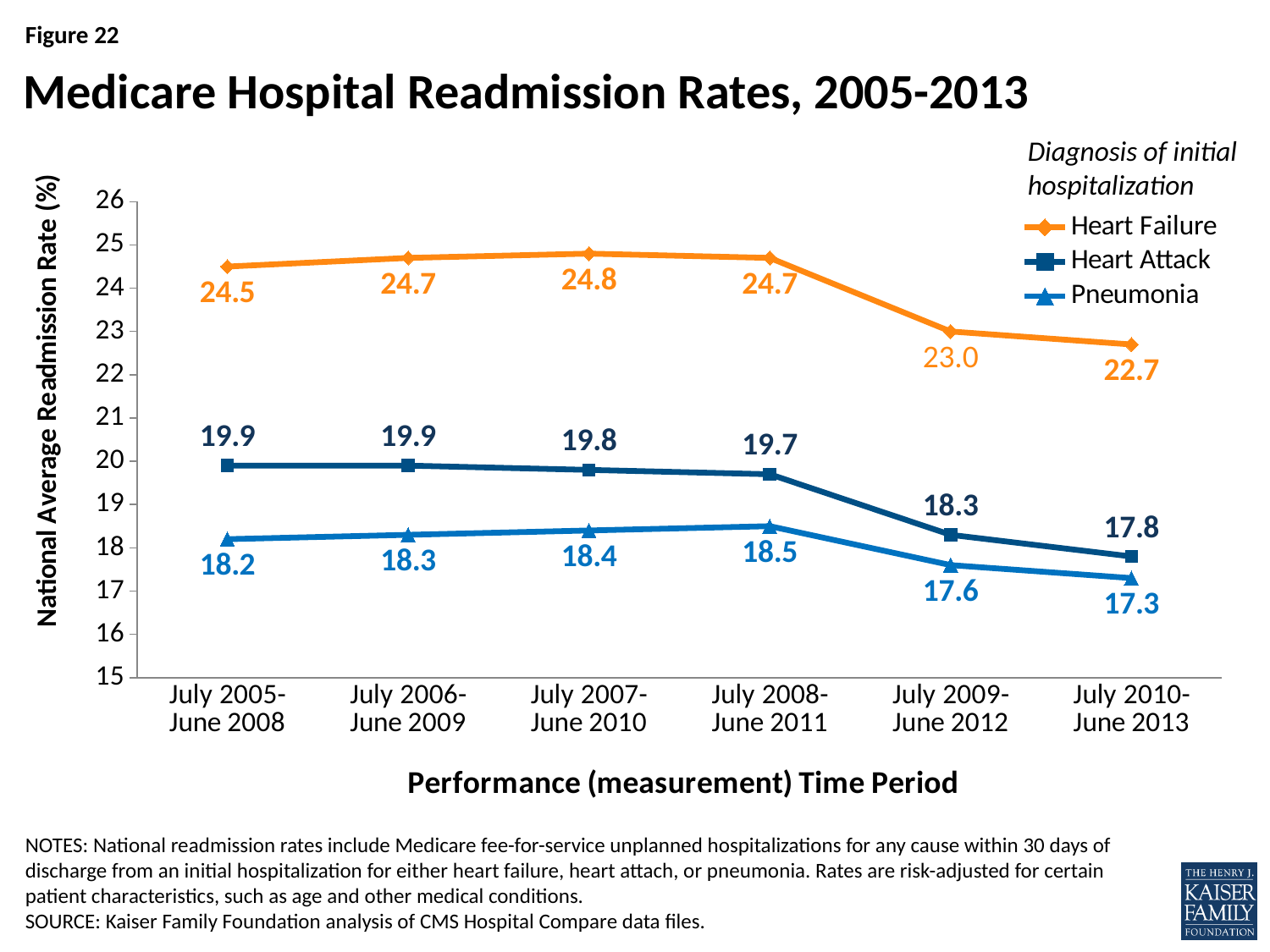
How many series does the legend list? 3 Did the Heart Attack readmission rate rise or fall from July 2008-June 2011 to July 2010-June 2013? Fall Which series had the higher readmission rate in July 2008-June 2011, Heart Attack or Pneumonia? Heart Attack In which time period was the Heart Failure readmission rate highest? July 2007-June 2010 What was the Heart Failure readmission rate in July 2007-June 2010? 24.8 What was the Heart Attack readmission rate in July 2009-June 2012? 18.3 What is the difference between the Heart Failure rate in July 2005-June 2008 and in July 2010-June 2013? 1.8 How many time periods are shown on the x axis? 6 In which time period was the Pneumonia readmission rate lowest? July 2010-June 2013 What was the Pneumonia readmission rate in July 2010-June 2013? 17.3 What kind of chart is shown on the slide? Line chart What is the title of the chart? Medicare Hospital Readmission Rates, 2005-2013